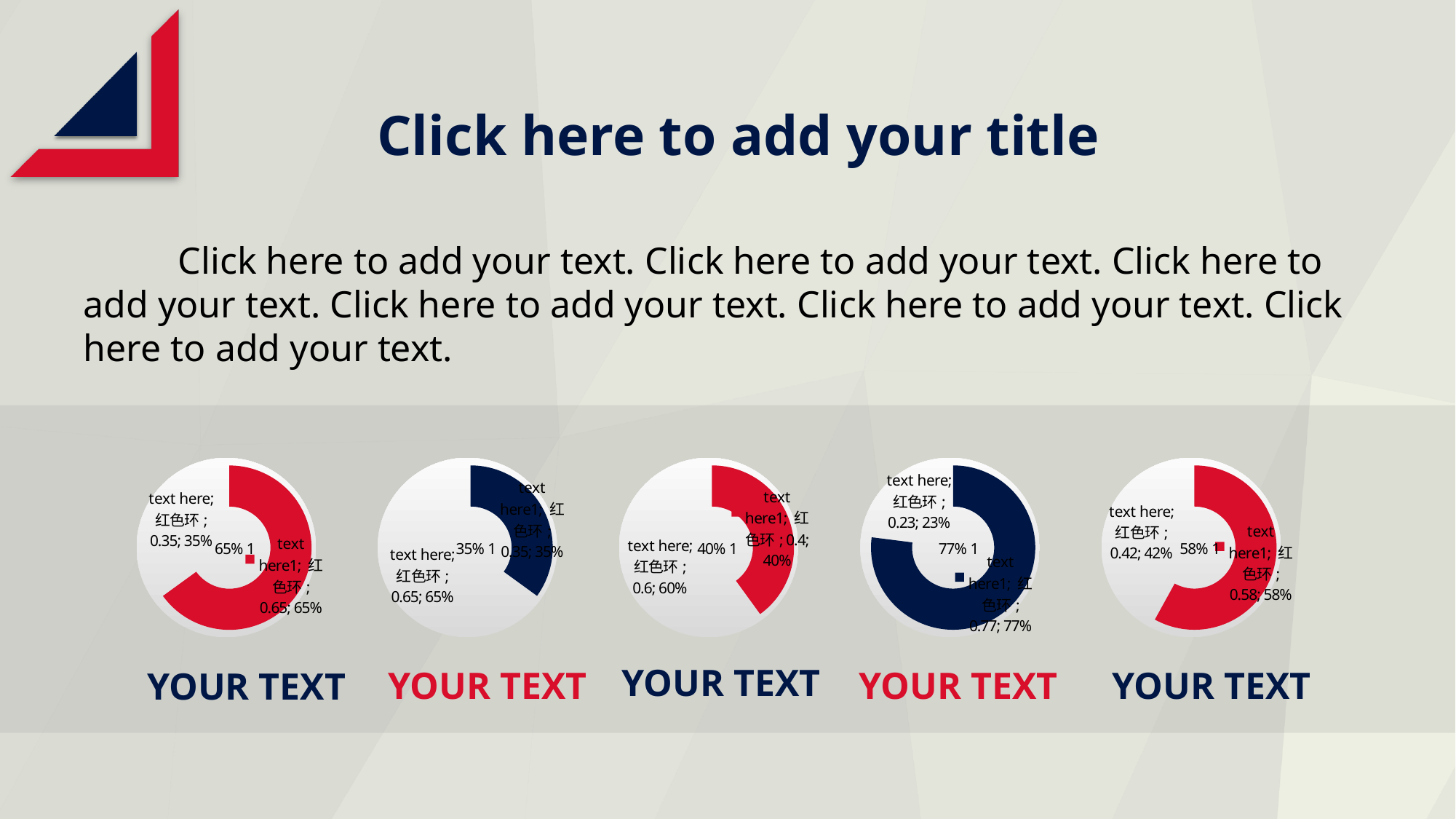
How many slices does the middle doughnut chart have? 2 In the leftmost doughnut chart, what percentage is shown for the 'text here' slice? 35% In the second doughnut chart from the left, what percentage is shown for the 'text here1' slice? 35% In the fourth doughnut chart from the left, what percentage is shown for the 'text here1' slice? 77% Which doughnut chart on the slide shows the highest percentage in its centre label? the fourth from the left (77%) In the rightmost doughnut chart, which slice is larger, 'text here' or 'text here1'? text here1 In the leftmost doughnut chart, what percentage is shown for the 'text here1' slice? 65% What kind of chart is the leftmost chart on the slide? doughnut chart In the fourth doughnut chart from the left, what is the difference in percentage points between the 'text here1' slice and the 'text here' slice? 54 In the middle doughnut chart, what value is shown for the 'text here' slice? 0.6 In the rightmost doughnut chart, what percentage is shown for the 'text here' slice? 42% How many doughnut charts are shown on the slide? 5